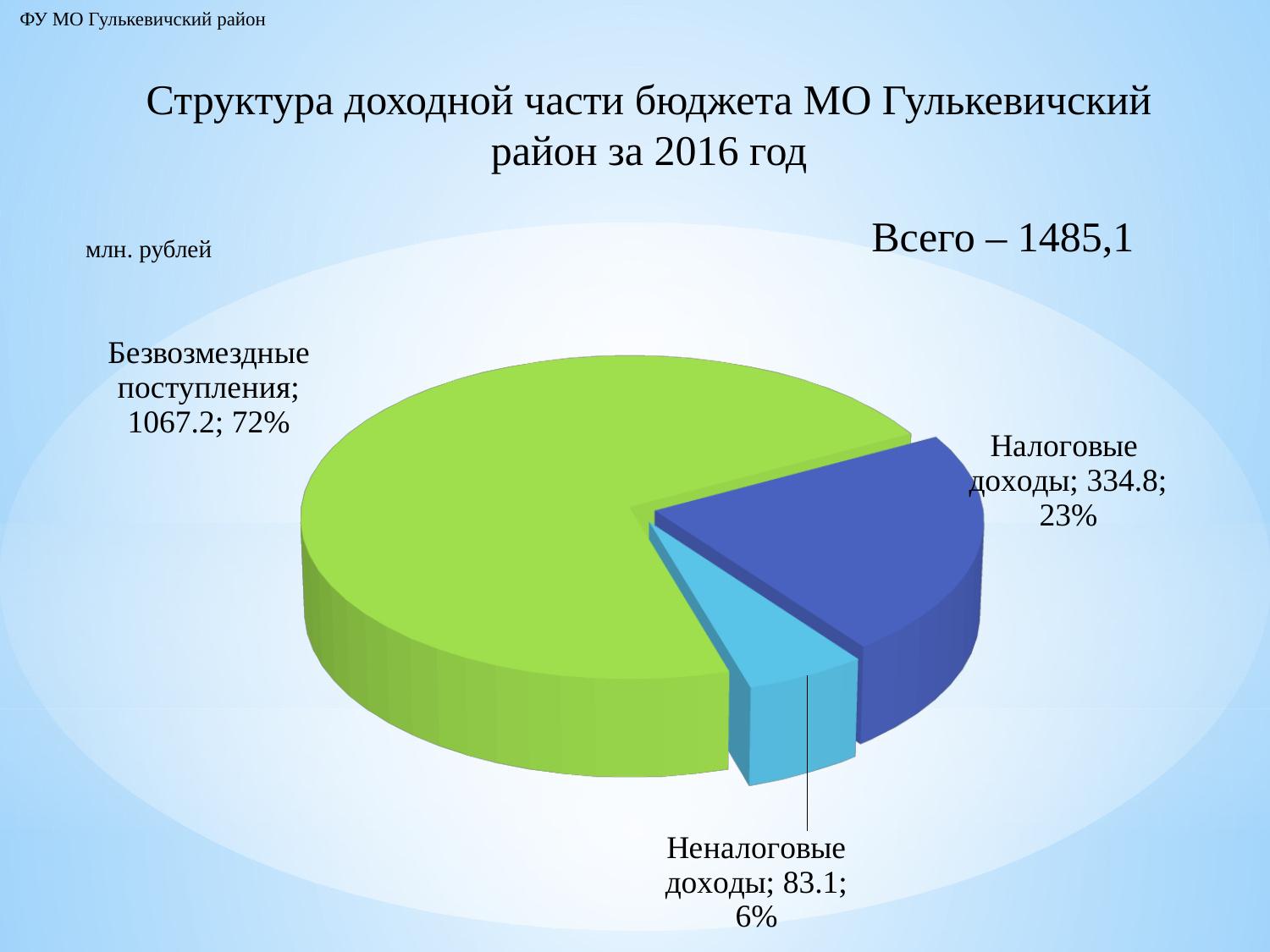
Which category has the largest slice? Безвозмездные поступления How many slices does the pie chart have? 3 What share of the pie does Безвозмездные поступления represent? 72% Which category has the smallest slice? Неналоговые доходы What total is stated on the slide for the budget revenue? 1485,1 What is the difference between Налоговые доходы and Неналоговые доходы? 251.7 What is the value for Неналоговые доходы? 83.1 What kind of chart is shown on the slide? pie chart What share of the pie does Налоговые доходы represent? 23% What is the value for Безвозмездные поступления? 1067.2 Which is larger, Налоговые доходы or Неналоговые доходы? Налоговые доходы What is the value for Налоговые доходы? 334.8